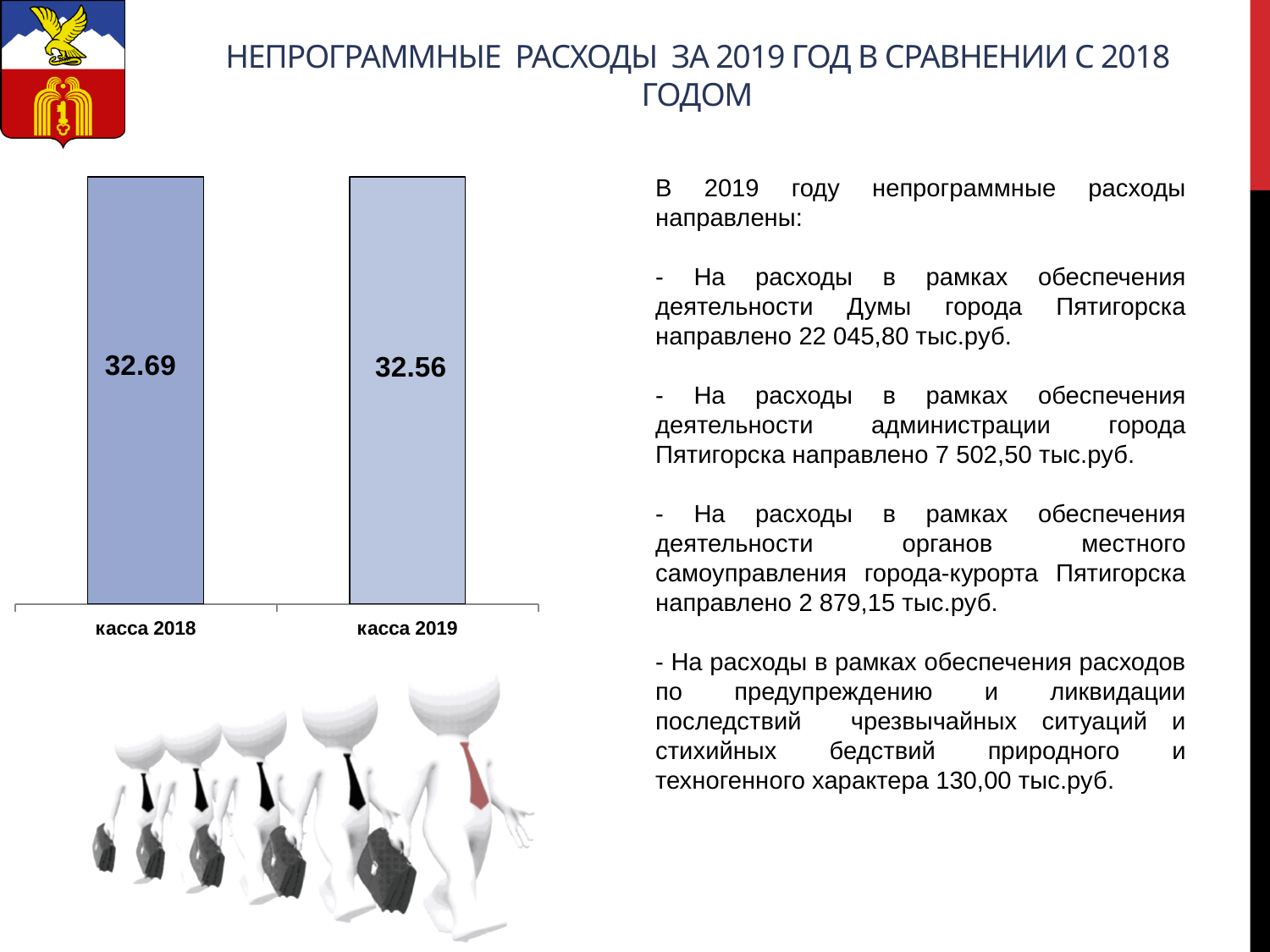
What is the value for касса 2019? 32.56 What is the value for касса 2018? 32.69 Which category has the highest value? касса 2018 What are the labels of the two categories on the x axis? касса 2018 and касса 2019 Which category has the lowest value? касса 2019 What is the difference between the values for касса 2018 and касса 2019? 0.13 What kind of chart is shown on the slide? bar chart Which category has the higher value, касса 2018 or касса 2019? касса 2018 What is the title of the slide containing the chart? НЕПРОГРАММНЫЕ РАСХОДЫ ЗА 2019 ГОД В СРАВНЕНИИ С 2018 ГОДОМ Do the values rise or fall from касса 2018 to касса 2019? fall How many categories are shown in the chart? 2